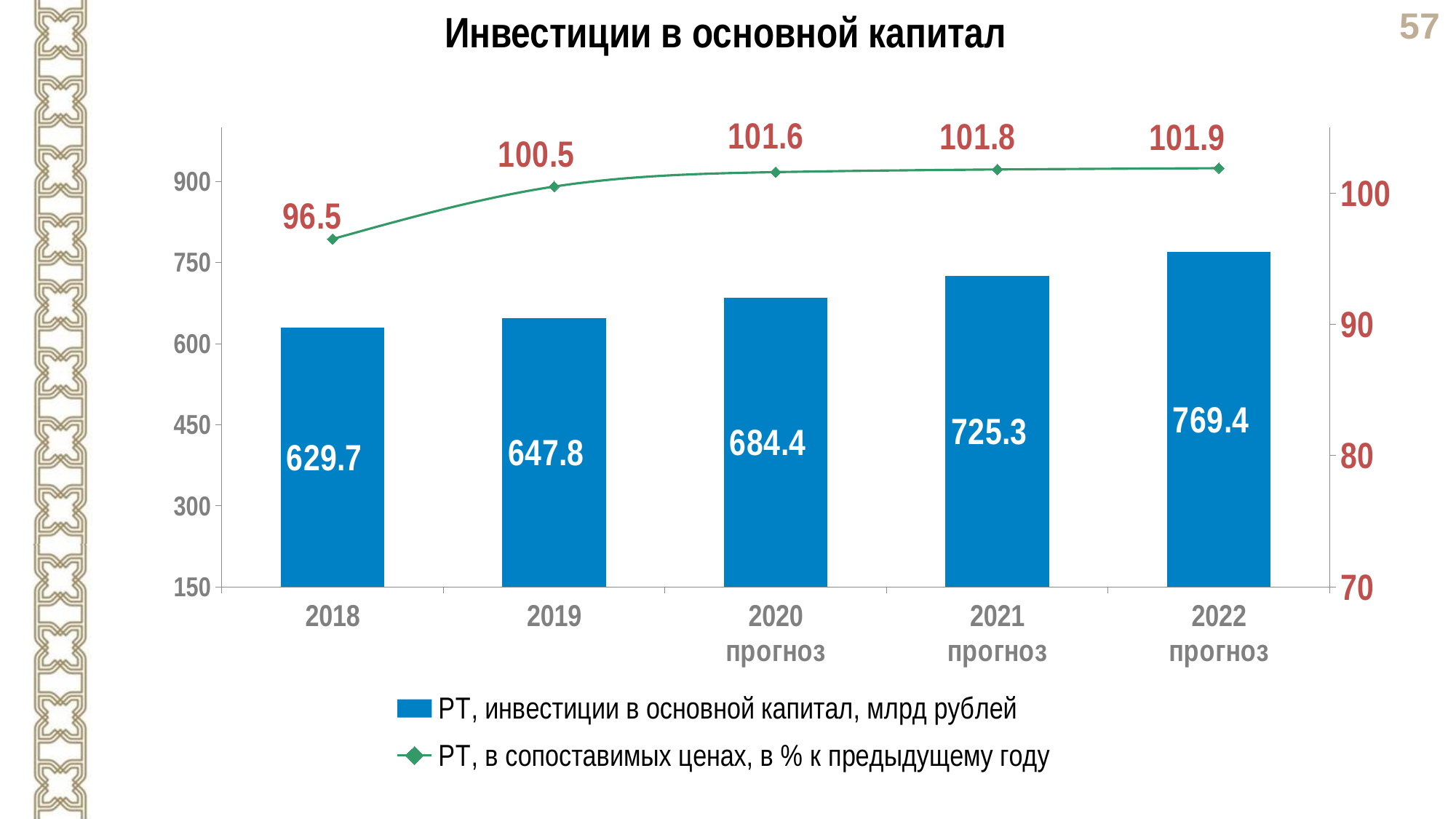
How many series does the legend list? 2 What is the difference between the РТ, инвестиции в основной капитал, млрд рублей values for 2022 прогноз and 2018? 139.7 What is the value of РТ, в сопоставимых ценах, в % к предыдущему году for 2020 прогноз? 101.6 What is the value of РТ, инвестиции в основной капитал, млрд рублей for 2018? 629.7 Which year has the highest value of РТ, инвестиции в основной капитал, млрд рублей? 2022 прогноз Which is larger: the РТ, инвестиции в основной капитал, млрд рублей value for 2019 or for 2020 прогноз? 2020 прогноз Which year has the lowest value of РТ, в сопоставимых ценах, в % к предыдущему году? 2018 What is the value of РТ, инвестиции в основной капитал, млрд рублей for 2021 прогноз? 725.3 What kind of chart is this? Combined bar and line chart Do the values of РТ, инвестиции в основной капитал, млрд рублей rise or fall from 2018 to 2022 прогноз? Rise What is the title of the chart? Инвестиции в основной капитал How many years are shown on the x axis? 5